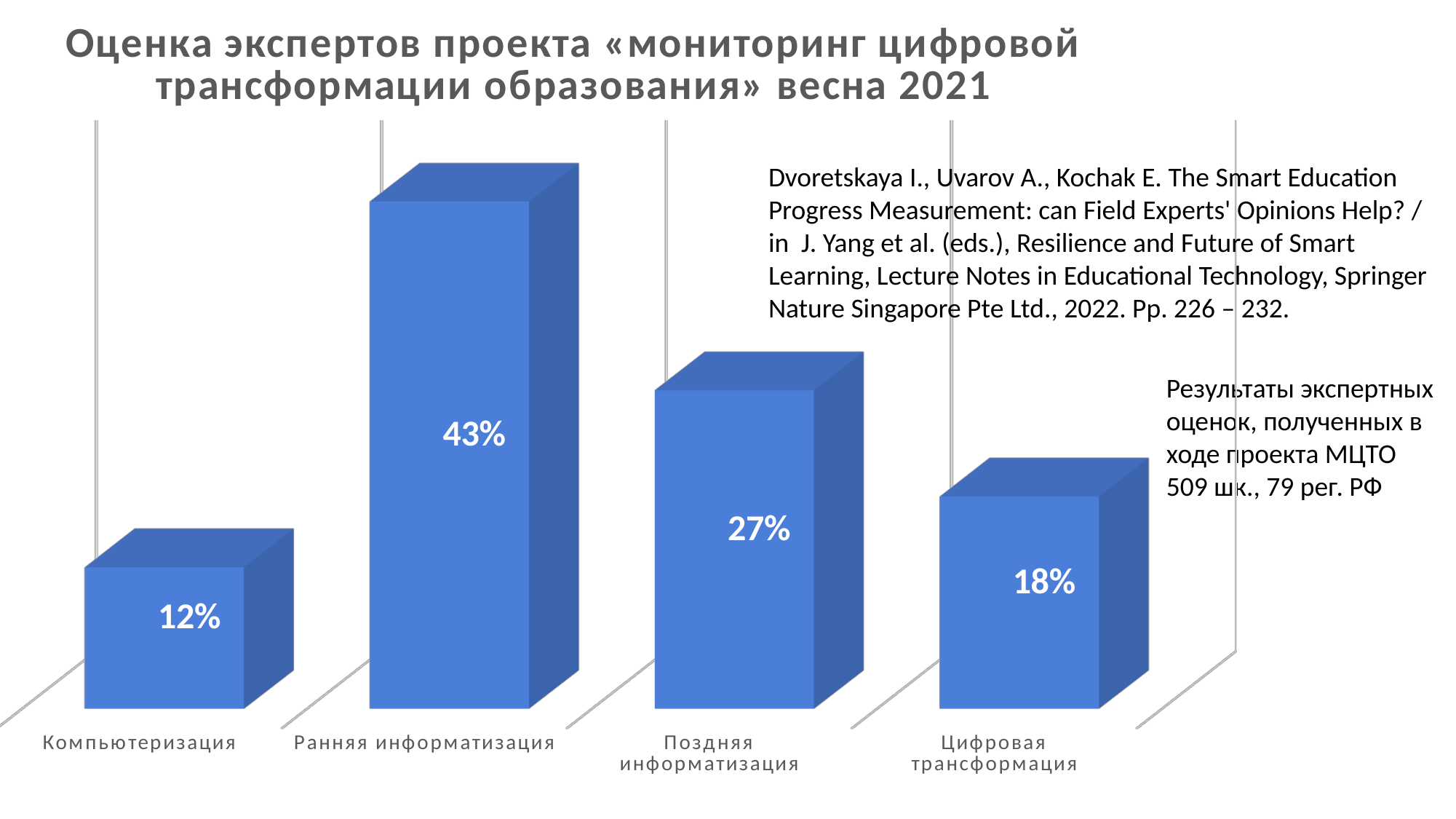
What is the difference between the values for Ранняя информатизация and Поздняя информатизация? 16% What is the value for Поздняя информатизация? 27% How many categories are shown in the chart? 4 Which category has the lowest value? Компьютеризация What is the value for Компьютеризация? 12% What kind of chart is shown on the slide? Bar chart What is the difference between the values for Цифровая трансформация and Компьютеризация? 6% Which is larger, the value for Поздняя информатизация or the value for Цифровая трансформация? Поздняя информатизация Which category has the highest value? Ранняя информатизация What is the total of all four values shown in the chart? 100% What is the value for Цифровая трансформация? 18% What is the value for Ранняя информатизация? 43%